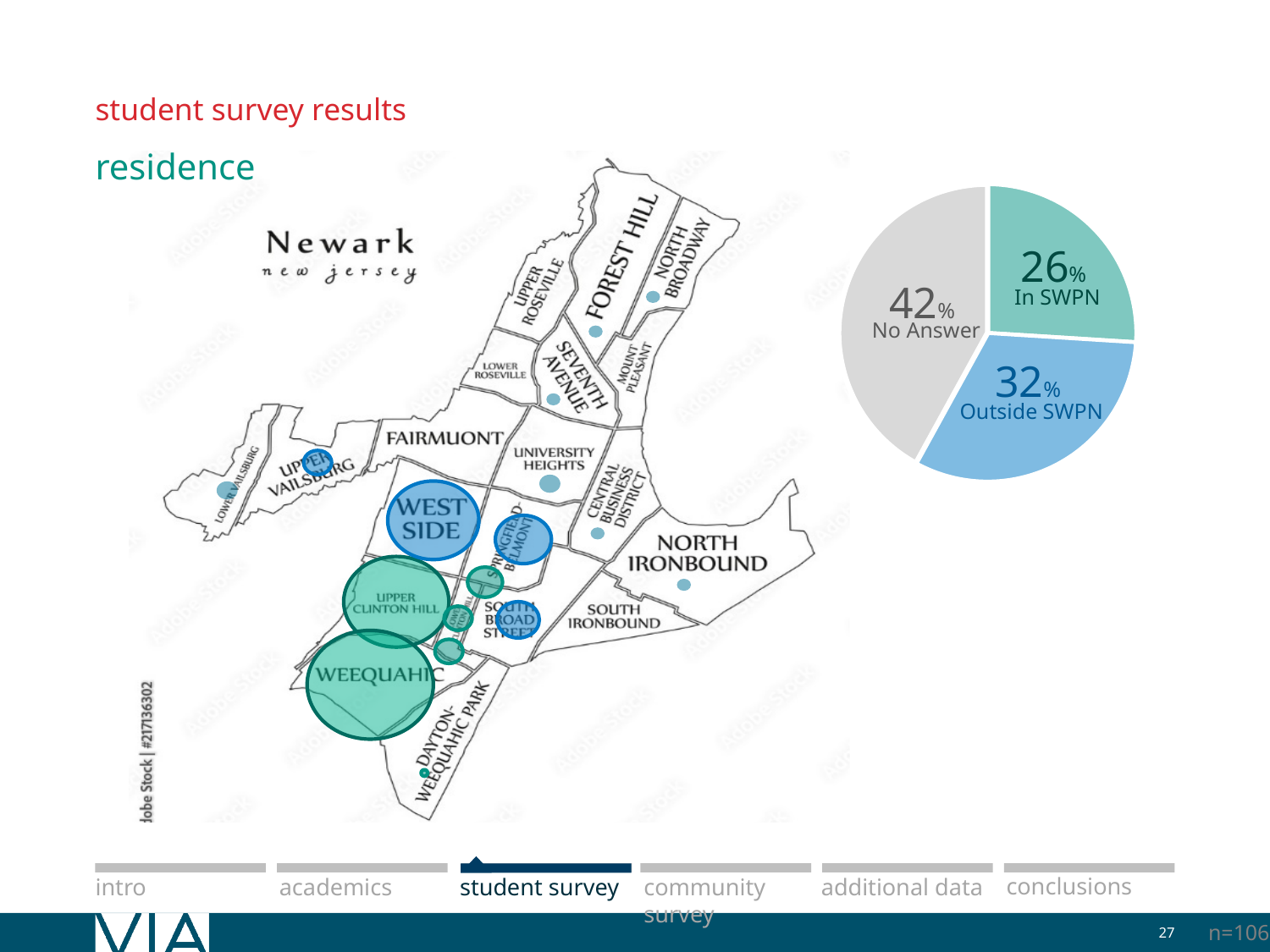
What kind of chart is shown on the right side of the slide? Pie chart Which slice of the pie chart is the largest? No Answer In the pie chart, what percentage of students gave no answer about their residence? 42% What is the combined percentage of students who answered the residence question (In SWPN plus Outside SWPN)? 58% What colour is the No Answer slice of the pie chart? Grey In the pie chart, what is the difference in percentage points between Outside SWPN and In SWPN? 6 In the pie chart, what percentage of students live outside SWPN? 32% How many slices does the pie chart have? 3 In the pie chart, which is larger: the share for In SWPN or the share for Outside SWPN? Outside SWPN In the pie chart, what is the difference in percentage points between No Answer and Outside SWPN? 10 In the pie chart, what percentage of students live in SWPN? 26% Which slice of the pie chart is the smallest? In SWPN